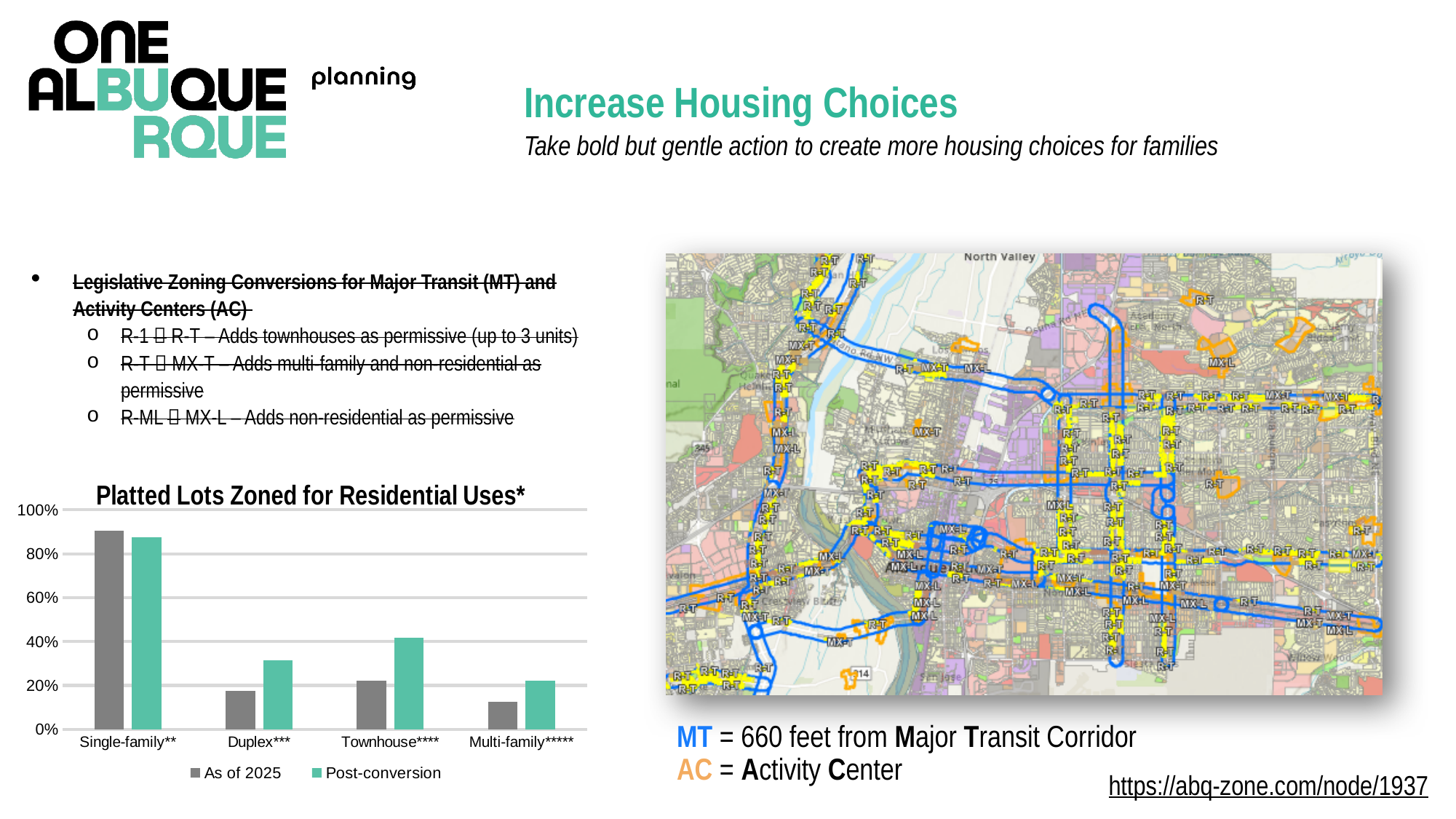
Which category has the lowest value for the As of 2025 series? Multi-family***** What is the title of the chart on the slide? Platted Lots Zoned for Residential Uses* Which series is shown in teal in the chart's legend? Post-conversion Is the Post-conversion value for Duplex*** greater or less than 20%? greater How many series does the chart's legend list? 2 Is the As of 2025 value for Multi-family***** greater or less than 20%? less How many categories are shown on the x axis of the chart? 4 Which category has the lowest value for the Post-conversion series? Multi-family***** Is the As of 2025 value for Single-family** greater or less than 80%? greater What kind of chart is shown on the slide? bar chart Which category has the highest value for the As of 2025 series? Single-family** For Townhouse****, which is larger: the As of 2025 value or the Post-conversion value? Post-conversion